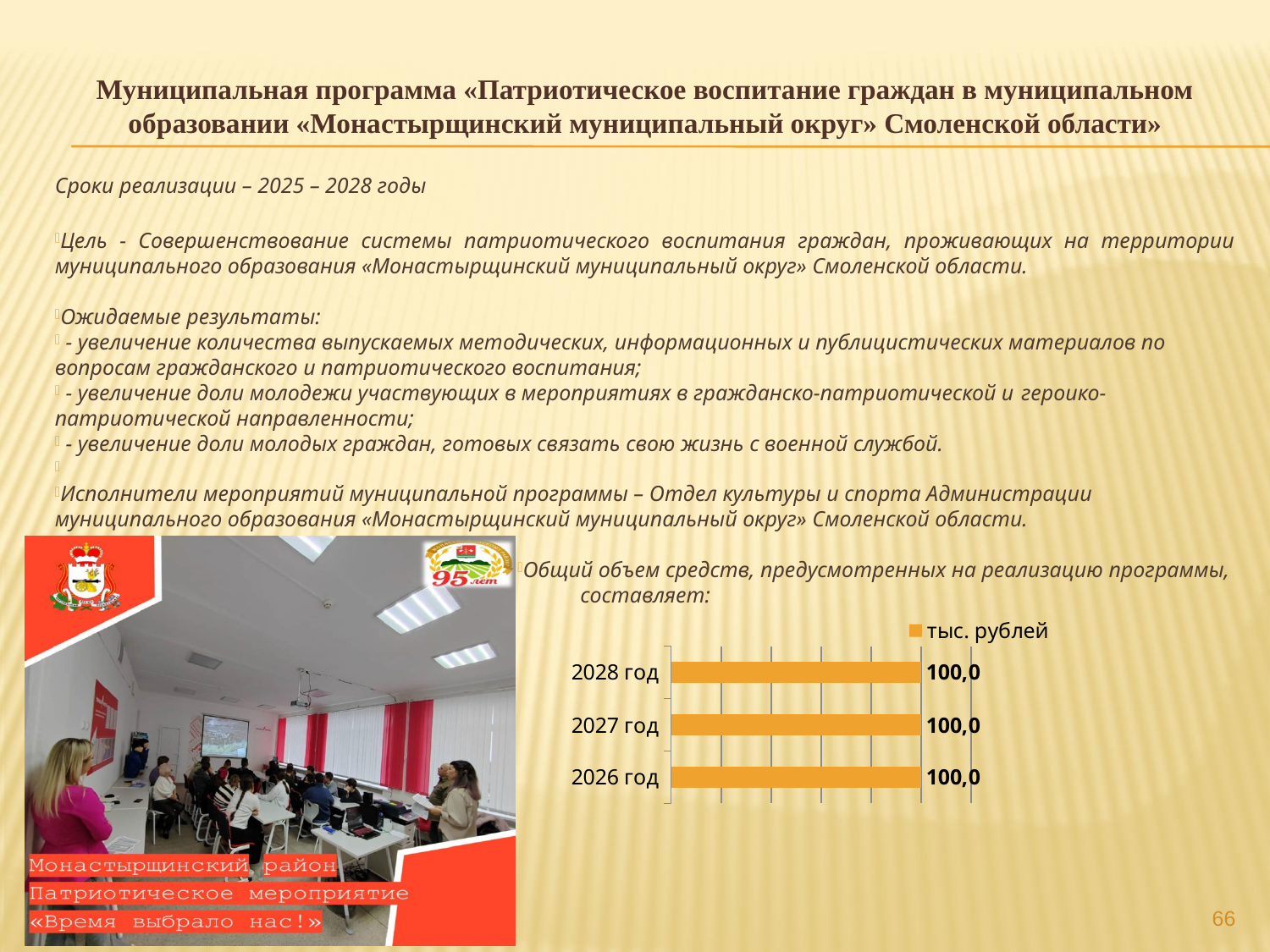
What is the value for 2026 год in the bar chart? 100,0 Do the values in the chart rise, fall, or stay the same from 2026 год to 2028 год? stay the same What is the difference between the values for 2028 год and 2026 год in the chart? 0,0 How many categories (years) are shown in the bar chart? 3 What is the value for 2027 год in the bar chart? 100,0 What is the legend entry shown for the series in the chart? тыс. рублей How many series does the chart legend list? 1 What is the value for 2028 год in the bar chart? 100,0 What colour are the bars in the chart? orange What kind of chart is shown on the slide? bar chart